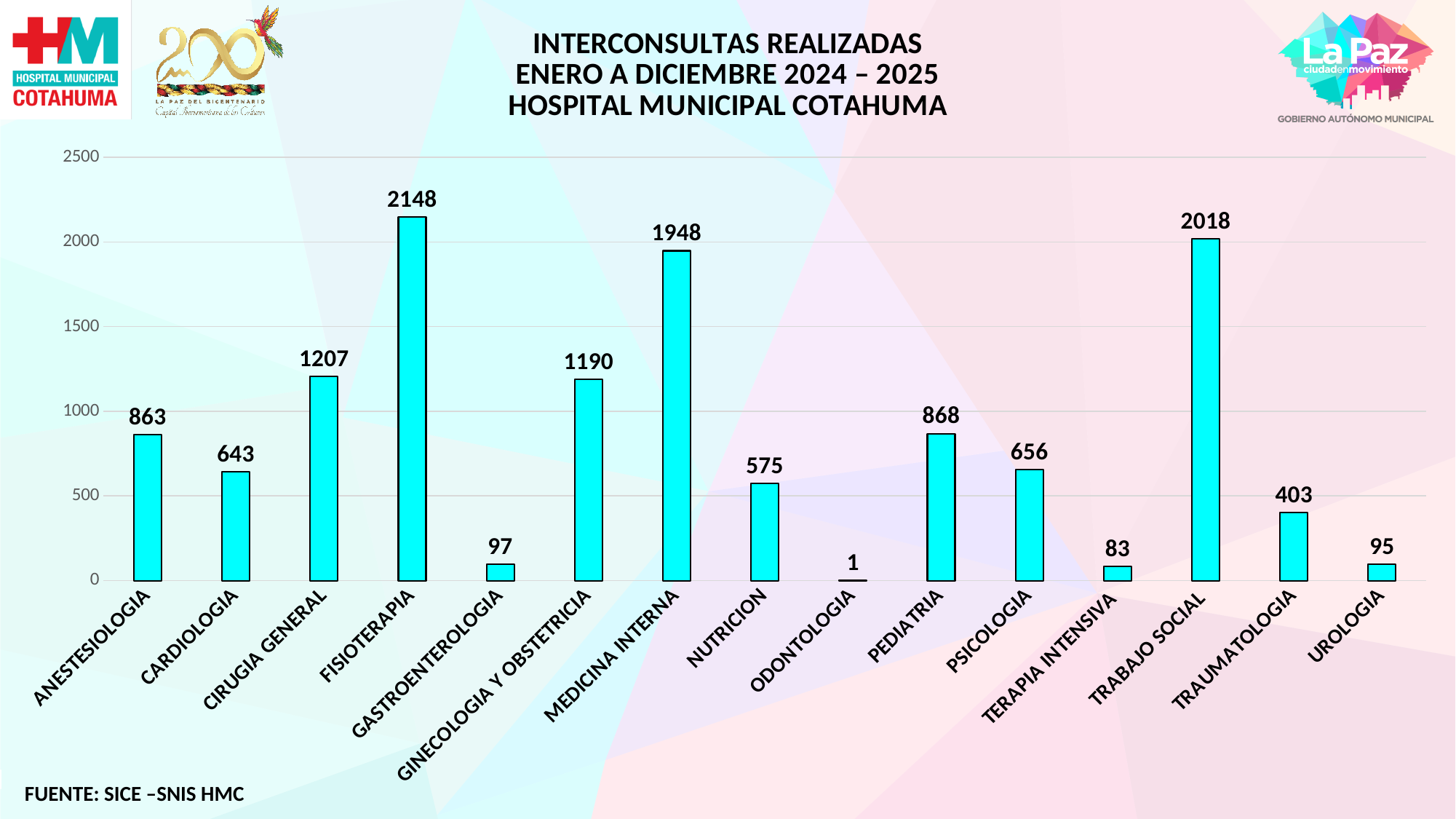
Is the value for TRAUMATOLOGIA greater or less than 500? less What is the value for MEDICINA INTERNA? 1948 What is the difference between the values for FISIOTERAPIA and TRABAJO SOCIAL? 130 What kind of chart is shown on the slide? bar chart Which category has the lowest value? ODONTOLOGIA What is the value for ODONTOLOGIA? 1 Which category has the highest value? FISIOTERAPIA What is the difference between the values for PEDIATRIA and PSICOLOGIA? 212 Which is larger, the value for CIRUGIA GENERAL or the value for GINECOLOGIA Y OBSTETRICIA? CIRUGIA GENERAL How many categories are shown on the x axis? 15 What is the value for FISIOTERAPIA? 2148 What source is cited at the bottom of the slide? SICE –SNIS HMC